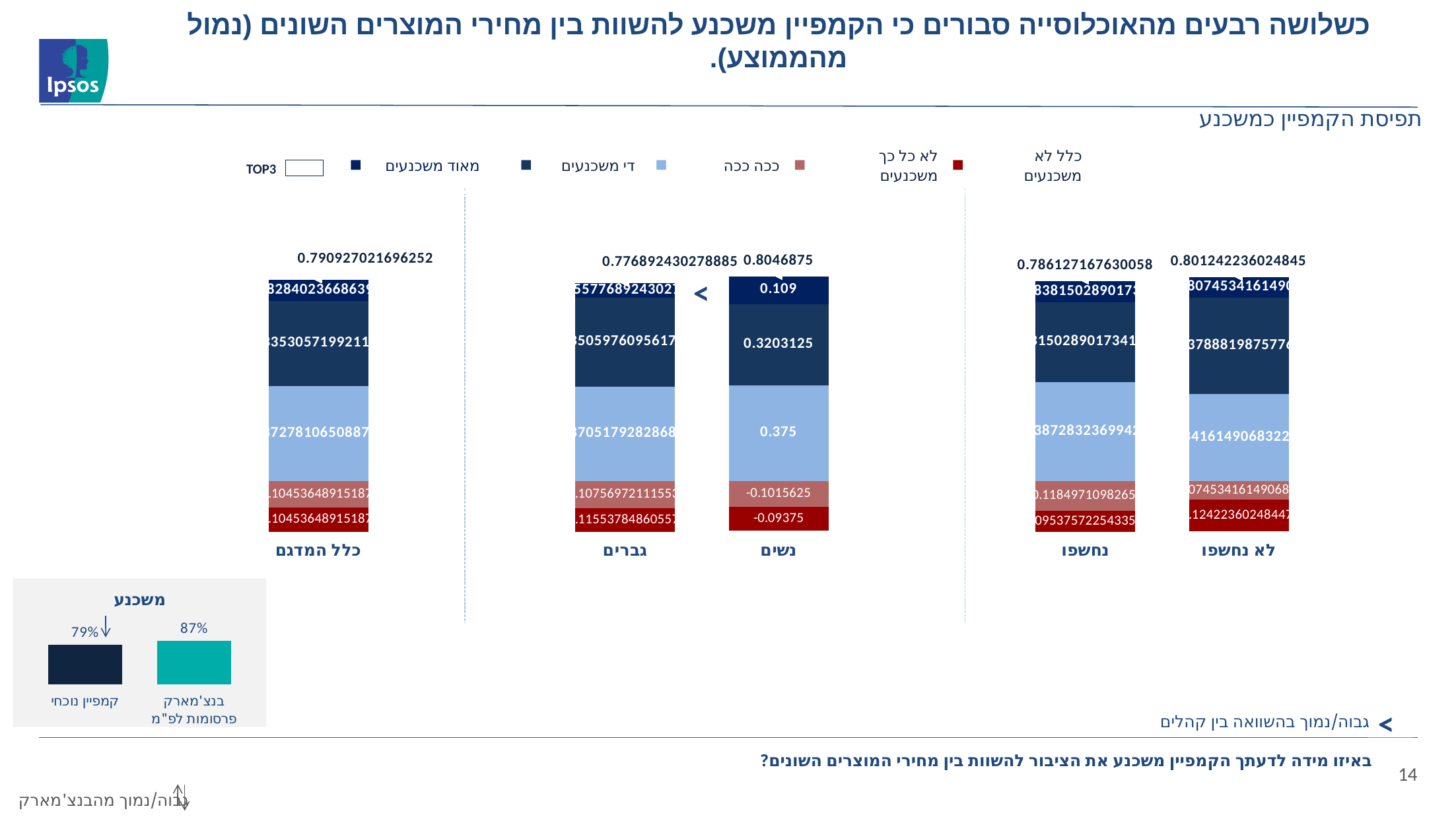
What is the TOP3 value printed above the גברים bar? 0.776892430278885 Excluding the TOP3 marker, how many coloured series does the legend list? 5 Which has a larger TOP3 value, נשים or גברים? נשים What is the difference between the TOP3 values of נשים and גברים? 0.027795069721115 What kind of chart is shown on the slide? stacked bar chart How many category groups (bars) are plotted along the x axis? 5 In the נשים bar, what is the value of the מאוד משכנעים segment? 0.109 What is the TOP3 value printed above the נשים bar? 0.8046875 In the נשים bar, what is the value of the ככה ככה segment? 0.375 Which category has the lowest TOP3 value? גברים Which category has the highest TOP3 value? נשים What is the TOP3 value printed above the לא נחשפו bar? 0.801242236024845